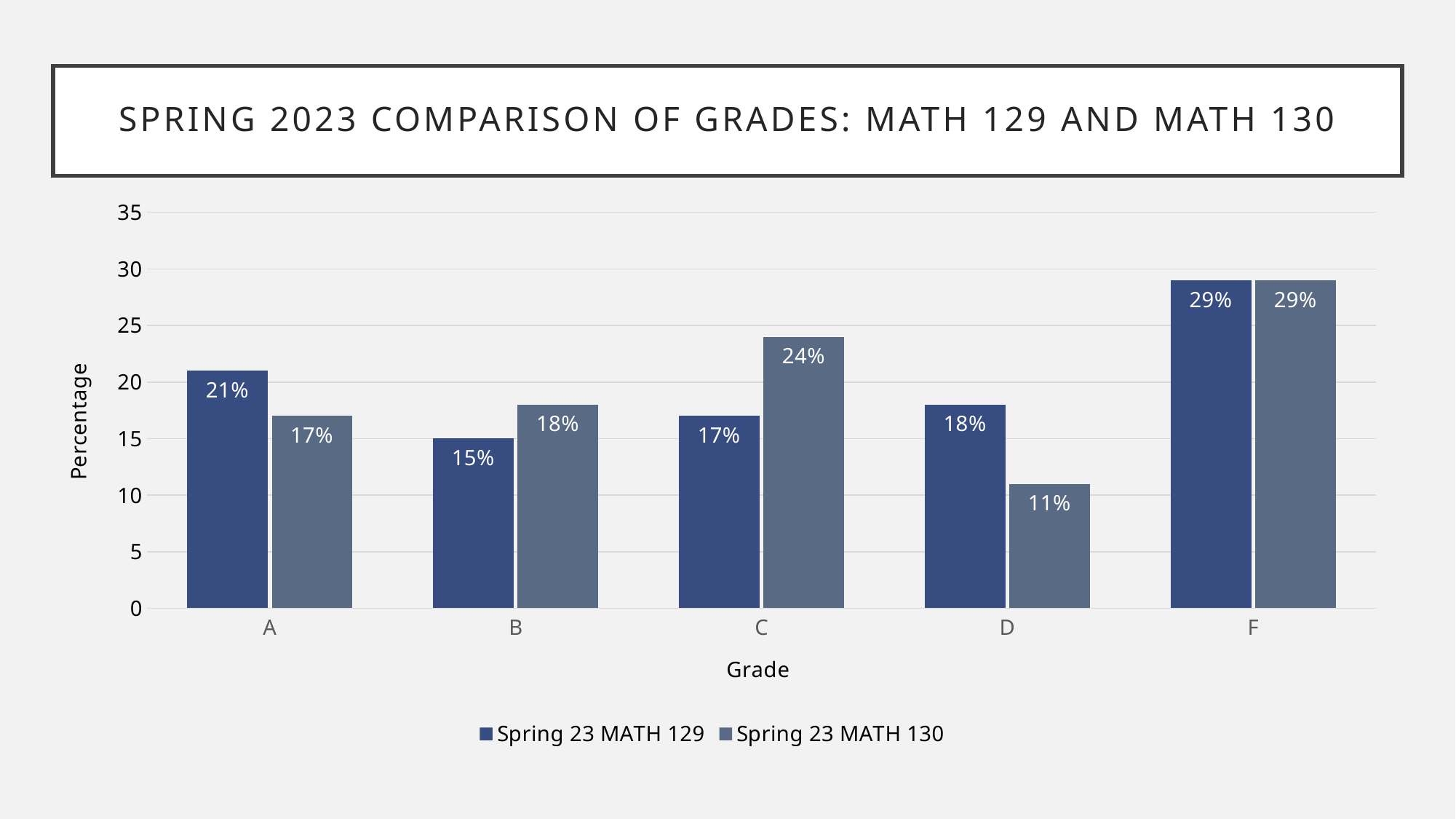
What kind of chart is shown on the slide? Bar chart How many series does the legend list? 2 For grade C, which series has the larger percentage, Spring 23 MATH 129 or Spring 23 MATH 130? Spring 23 MATH 130 What percentage of Spring 23 MATH 129 students received a grade of A? 21% Is the Spring 23 MATH 129 value for grade B greater or less than 20? less What percentage of Spring 23 MATH 130 students received a grade of D? 11% Which grade has the highest percentage for Spring 23 MATH 129? F How many grade categories are shown on the x axis? 5 What is the difference between the Spring 23 MATH 129 and Spring 23 MATH 130 percentages for grade D? 7% Which grade has the lowest percentage for Spring 23 MATH 130? D What is the label of the y axis? Percentage What percentage of Spring 23 MATH 130 students received a grade of C? 24%